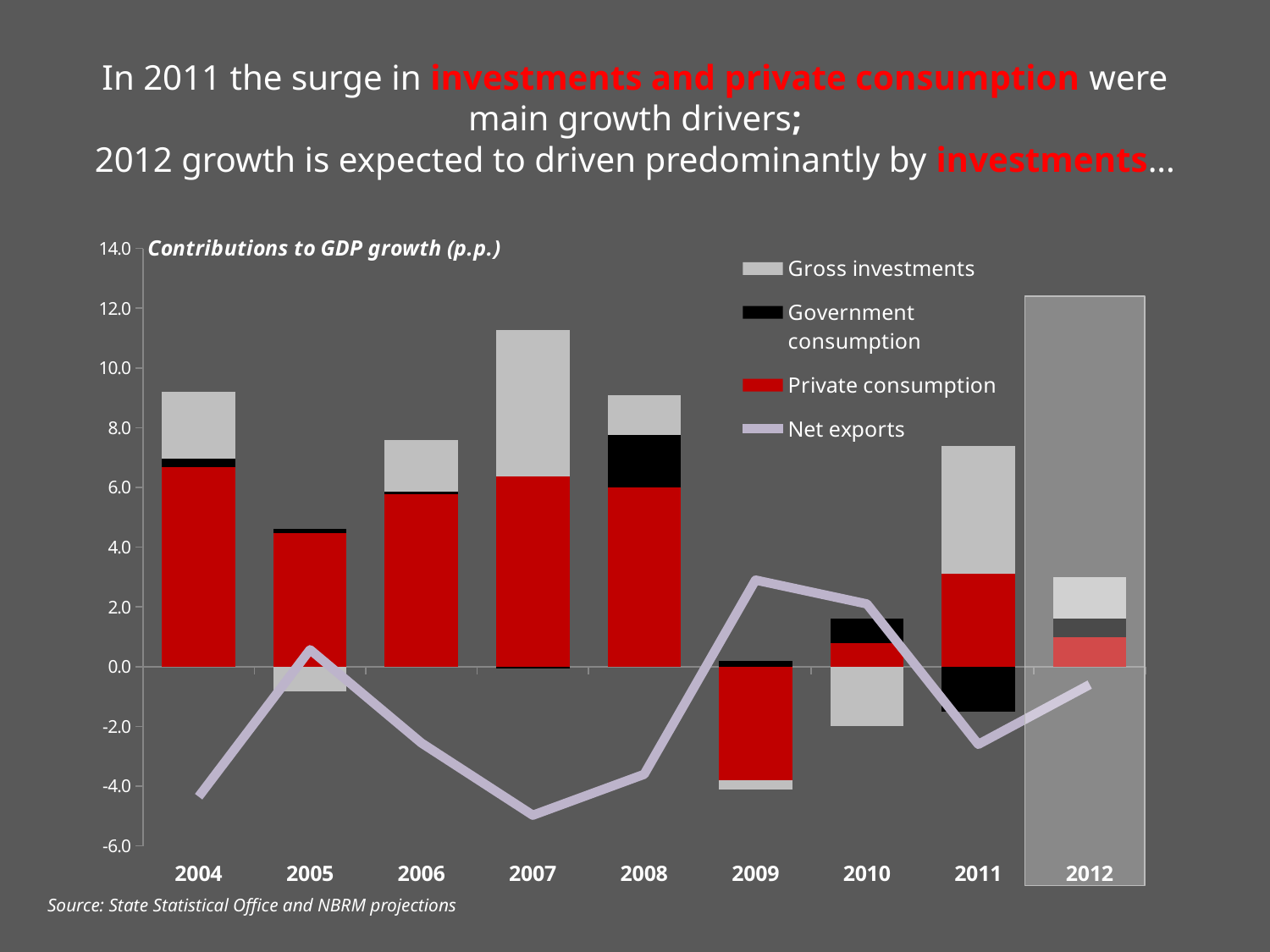
Is the Net exports value for 2009 greater or less than 2.0? greater How many years are shown on the x axis of the chart? 9 Is the Private consumption contribution in 2004 greater or less than 4.0? greater Is the Net exports value for 2007 greater or less than -4.0? less Which year has the highest Net exports value? 2009 Which year has the larger Private consumption contribution, 2008 or 2011? 2008 Does the Net exports line rise or fall from 2005 to 2007? fall Which series is drawn as a line rather than as bars? Net exports How many series does the chart legend list? 4 What kind of chart is used to show the contributions to GDP growth? Stacked bar chart with a line What is the title of the chart? Contributions to GDP growth (p.p.)